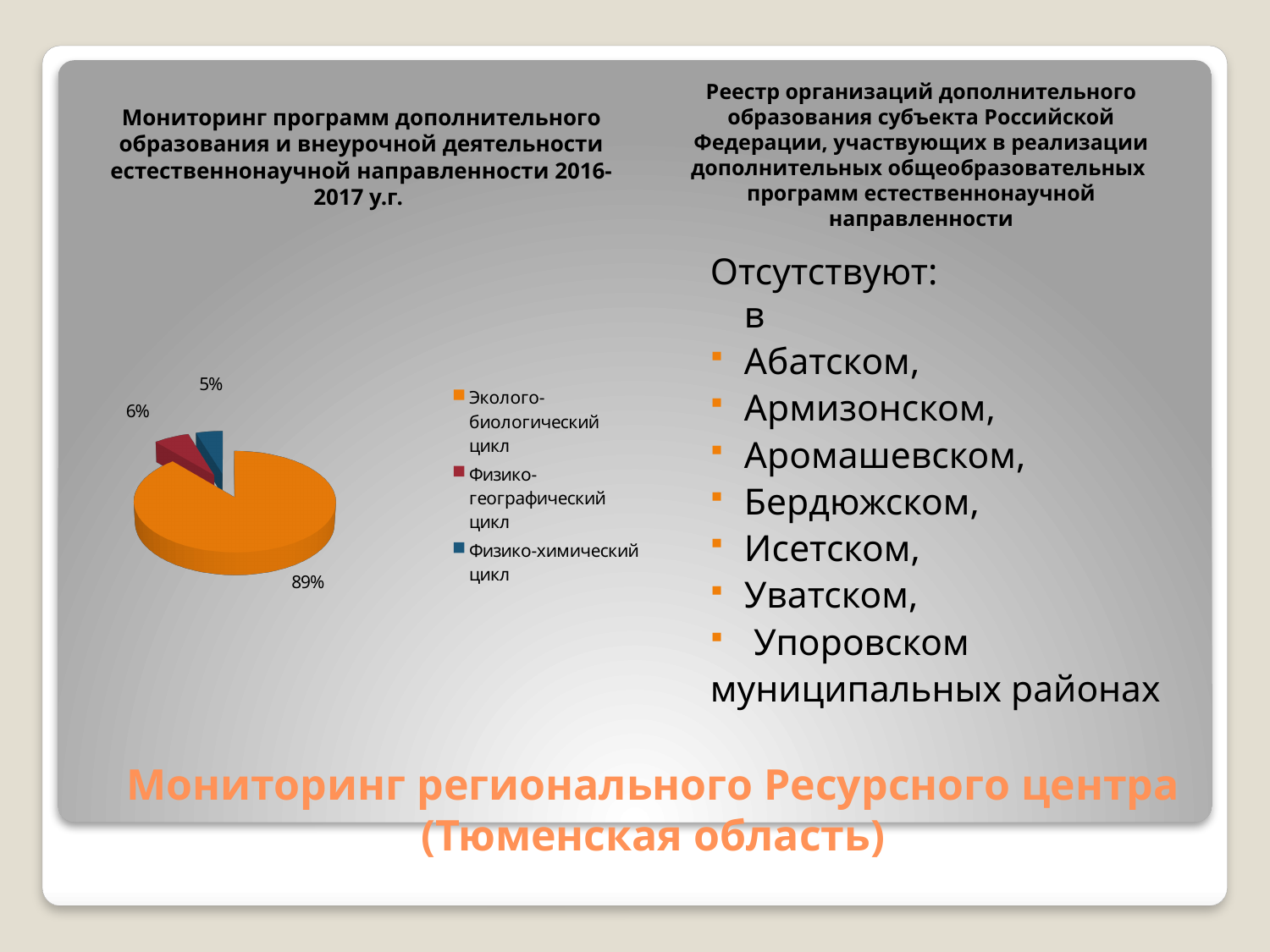
Which category has the largest slice of the pie? Эколого-биологический цикл What colour is the slice for Эколого-биологический цикл? Orange Which is larger, the share for Физико-географический цикл or the share for Физико-химический цикл? Физико-географический цикл What is the title of the pie chart? Мониторинг программ дополнительного образования и внеурочной деятельности естественнонаучной направленности 2016-2017 у.г. How many slices does the pie chart have? 3 What share of the pie does Физико-географический цикл have? 6% What kind of chart is shown on the slide? Pie chart What share of the pie does Физико-химический цикл have? 5% How many entries does the legend list? 3 What share of the pie does Эколого-биологический цикл have? 89% Which category has the smallest slice of the pie? Физико-химический цикл What is the difference in percentage points between Эколого-биологический цикл and Физико-географический цикл? 83